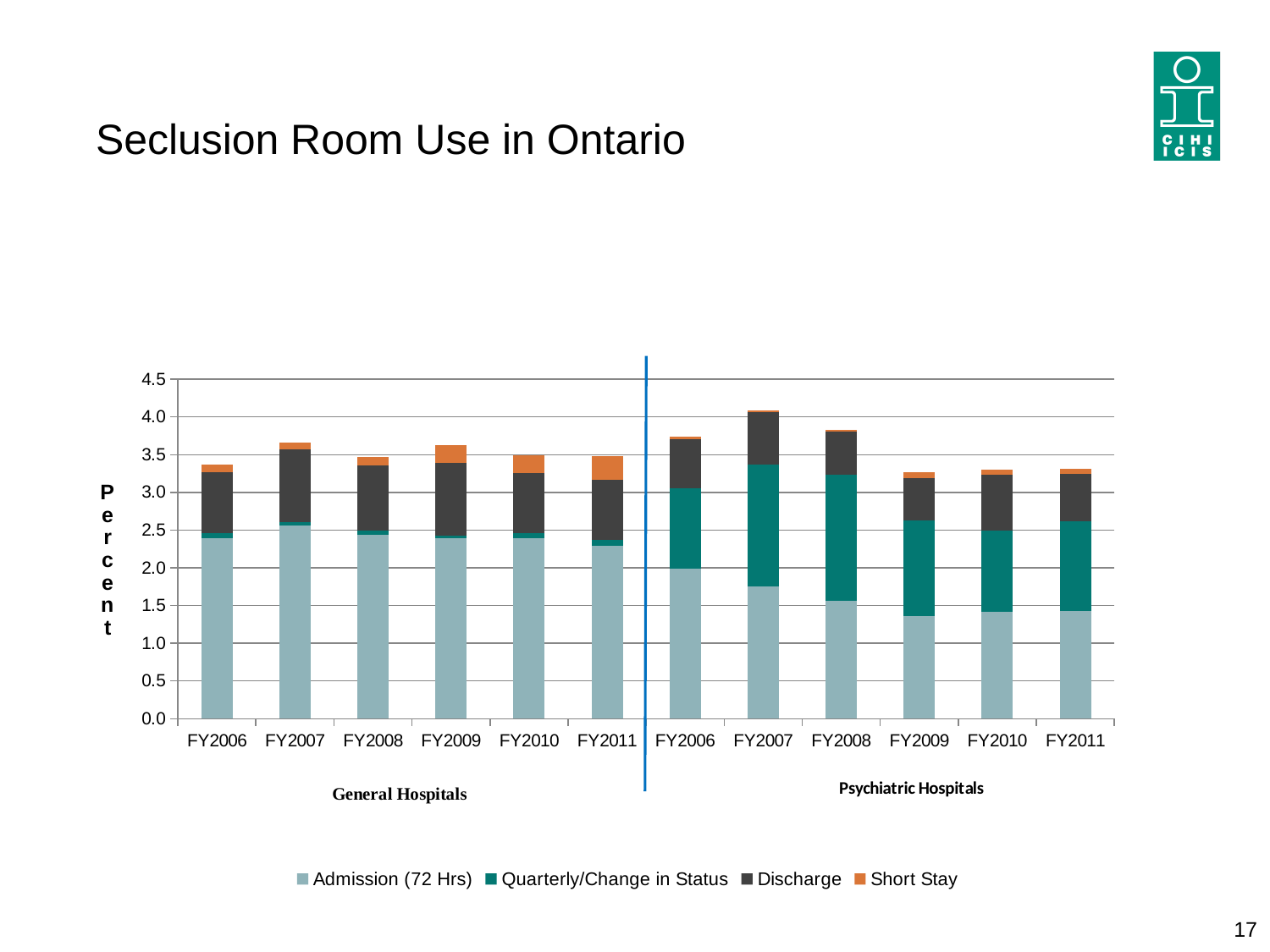
Is the total for Psychiatric Hospitals FY2007 greater or less than 3.5? greater How many fiscal years are shown for Psychiatric Hospitals? 6 Is the Admission (72 Hrs) value for Psychiatric Hospitals FY2007 greater or less than 2.0? less How many series does the legend list? 4 What is the label on the vertical axis of the chart? Percent Which bar has the highest total in the chart? Psychiatric Hospitals FY2007 How many bars are plotted in the chart in total? 12 What kind of chart is shown on the slide? Stacked bar chart Which has the larger Admission (72 Hrs) value: General Hospitals FY2006 or Psychiatric Hospitals FY2006? General Hospitals FY2006 Which has the larger total: General Hospitals FY2006 or General Hospitals FY2007? General Hospitals FY2007 Does the Admission (72 Hrs) value for Psychiatric Hospitals rise or fall from FY2006 to FY2009? fall Is the Admission (72 Hrs) value for Psychiatric Hospitals FY2009 greater or less than 1.5? less